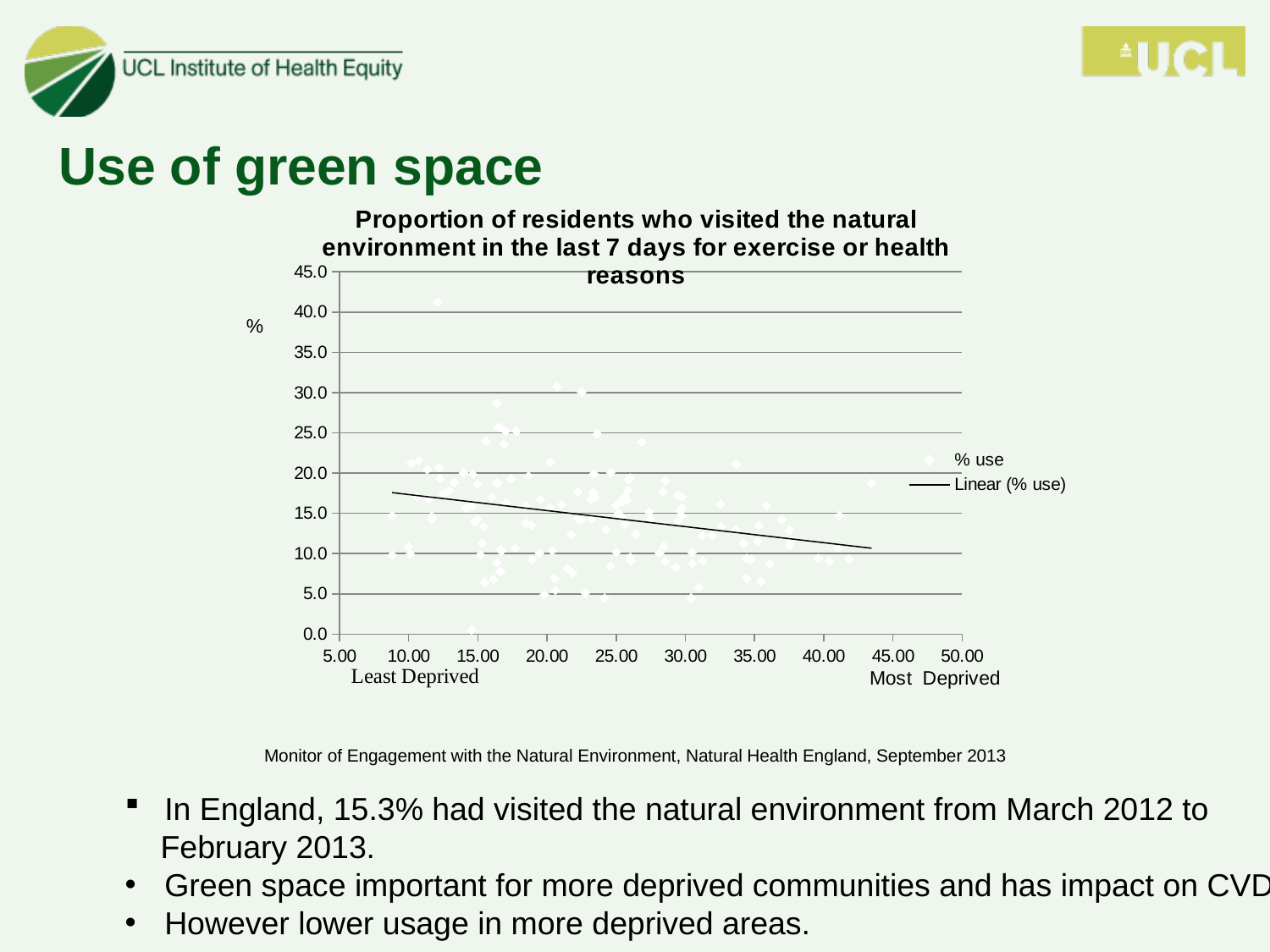
Is the lowest plotted point on the chart greater or less than 10.0? less What is the maximum value shown on the y axis of the chart? 45.0 Is the value of the linear trend line at x = 40.00 greater or less than 15.0? less What is the maximum value shown on the x axis of the chart? 50.00 Is the highest plotted point on the chart greater or less than 35.0? greater How many entries does the chart legend list? 2 What kind of chart is shown on the slide? scatter chart What are the two legend entries of the chart? % use; Linear (% use) Does the linear trend line rise or fall as deprivation increases along the x axis? falls What is the title of the chart? Proportion of residents who visited the natural environment in the last 7 days for exercise or health reasons